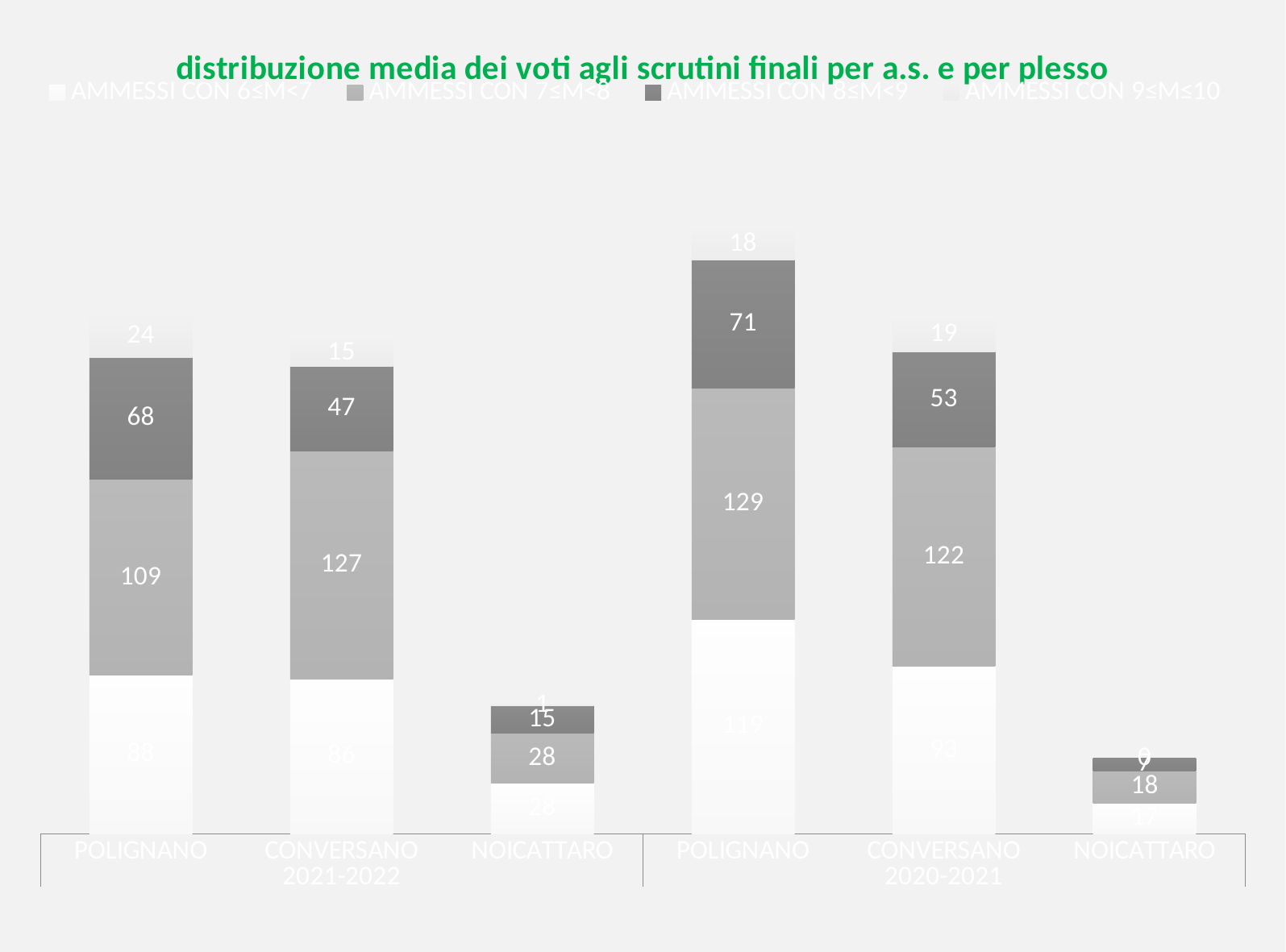
What is the value of AMMESSI CON 9≤M≤10 for POLIGNANO in 2021-2022? 24 What kind of chart is shown on the slide? Stacked bar chart Among the 2021-2022 bars, which plesso has the lowest value for AMMESSI CON 8≤M<9? NOICATTARO What is the value of AMMESSI CON 9≤M≤10 for CONVERSANO in 2020-2021? 19 What is the difference between the AMMESSI CON 8≤M<9 values for POLIGNANO and CONVERSANO in 2021-2022? 21 How many bars are plotted in the chart? 6 What is the value of AMMESSI CON 7≤M<8 for CONVERSANO in 2021-2022? 127 In 2021-2022, which has the larger AMMESSI CON 7≤M<8 value, POLIGNANO or CONVERSANO? CONVERSANO What is the value of AMMESSI CON 8≤M<9 for POLIGNANO in 2020-2021? 71 What is the total of the stacked bar for POLIGNANO in 2021-2022? 289 Which bar has the highest value for AMMESSI CON 7≤M<8? POLIGNANO 2020-2021 How many series does the legend list? 4